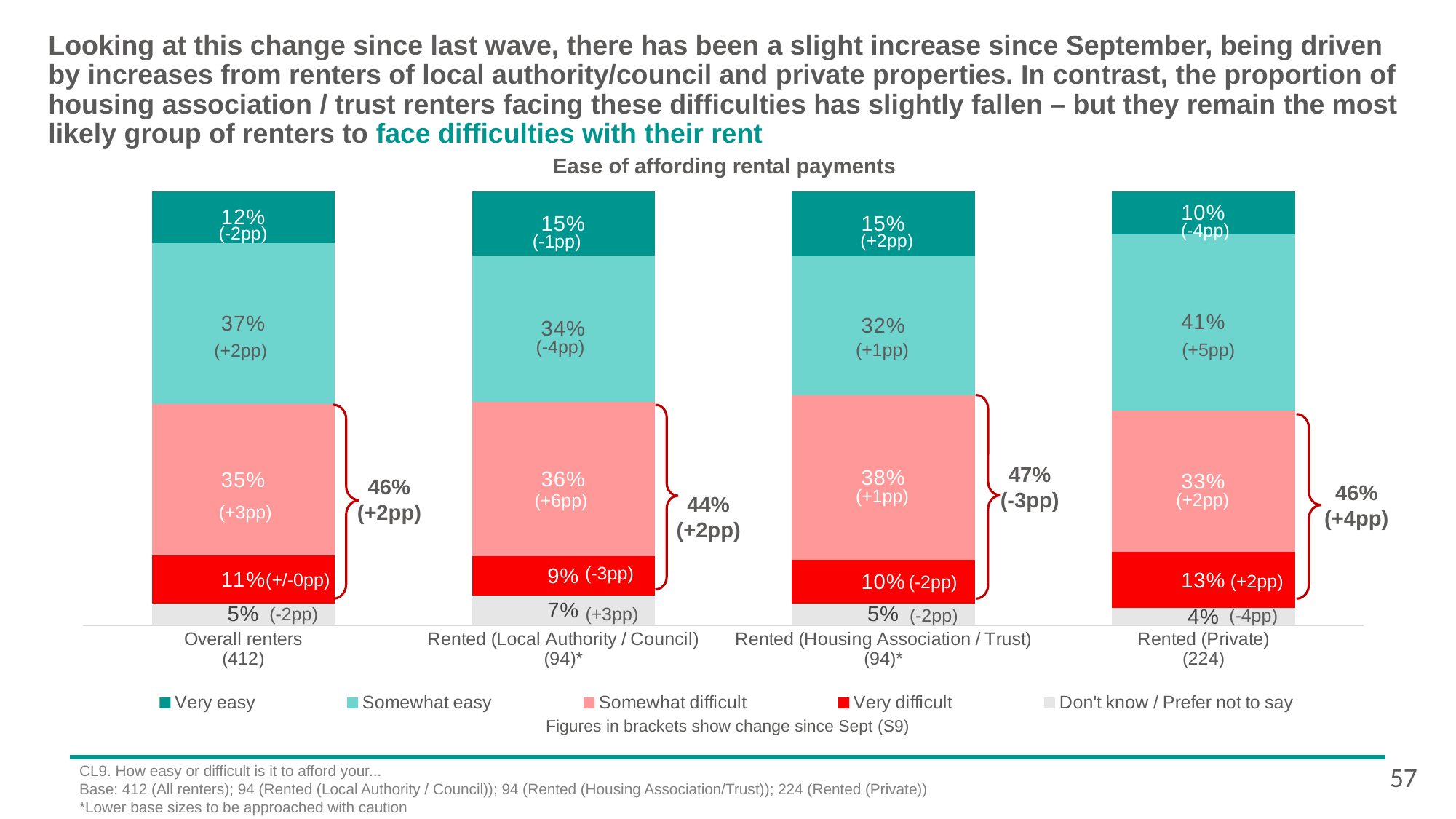
Which is larger: the 'Very difficult' value for Overall renters or for Rented (Local Authority / Council)? Overall renters Which renter group has the highest 'Somewhat easy' value? Rented (Private) What percentage of Overall renters said it is 'Somewhat easy' to afford rental payments? 37% Which renter group has the lowest 'Very easy' value? Rented (Private) What is the total of the stacked bar for Overall renters? 100% What is the difference between the 'Somewhat difficult' values for Rented (Housing Association / Trust) and Rented (Private)? 5 percentage points What kind of chart is shown on the slide? Stacked bar chart What is the 'Very difficult' value for Rented (Private)? 13% What is the title of the chart? Ease of affording rental payments What is the 'Don't know / Prefer not to say' value for Rented (Local Authority / Council)? 7% How many series does the legend list? 5 How many renter groups are shown on the x axis of the chart? 4